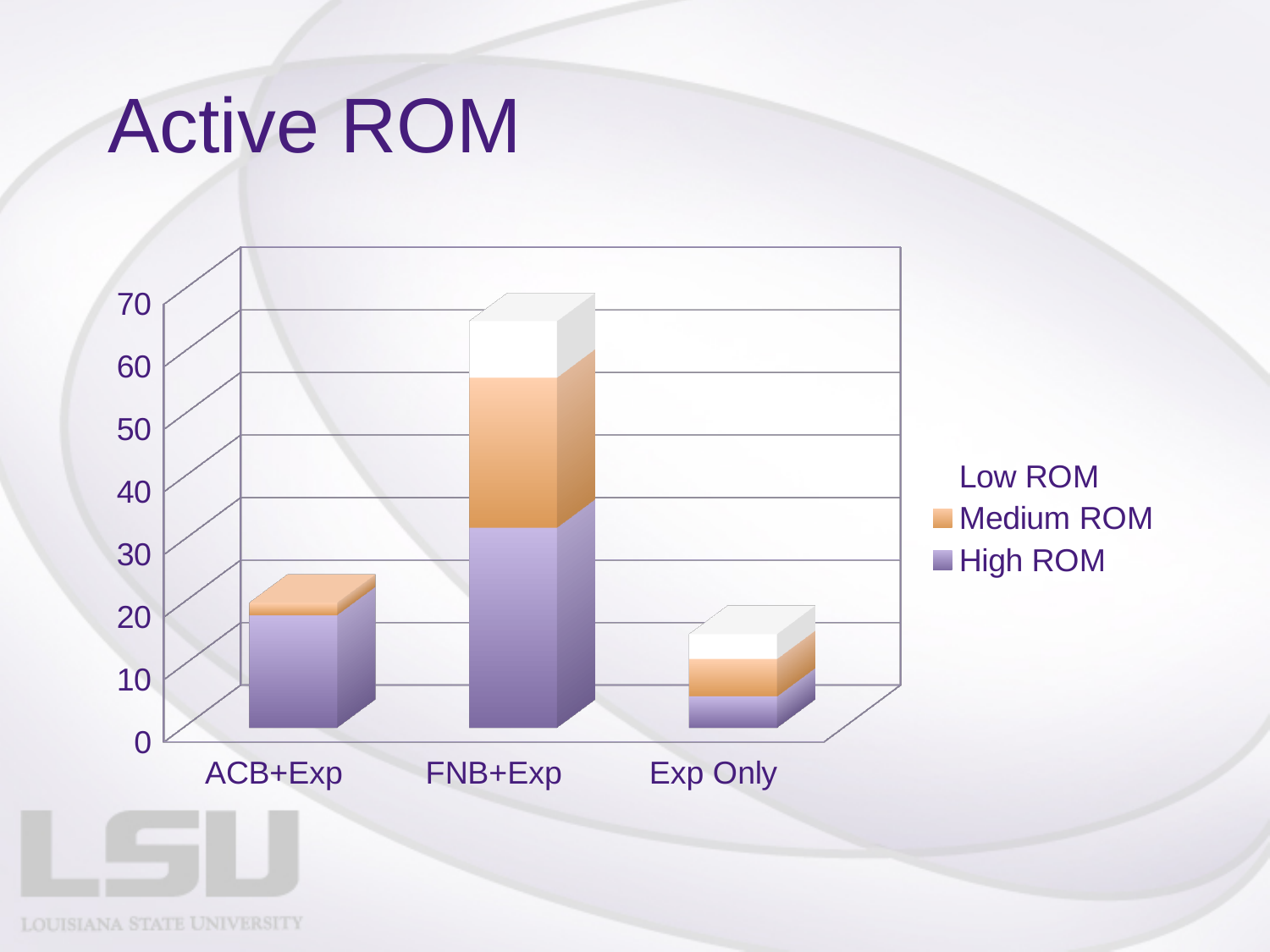
What kind of chart is shown on the slide? Stacked bar chart Which category has the tallest stacked bar? FNB+Exp Is the High ROM value for FNB+Exp greater or less than 20? greater What is the title of the chart? Active ROM Which stacked bar is taller, ACB+Exp or Exp Only? ACB+Exp Is the total stacked value for FNB+Exp greater or less than 50? greater Is the total stacked value for ACB+Exp greater or less than 30? less Which series does the legend list first? Low ROM How many categories are shown on the x axis? 3 Which category has the shortest stacked bar? Exp Only How many series does the legend list? 3